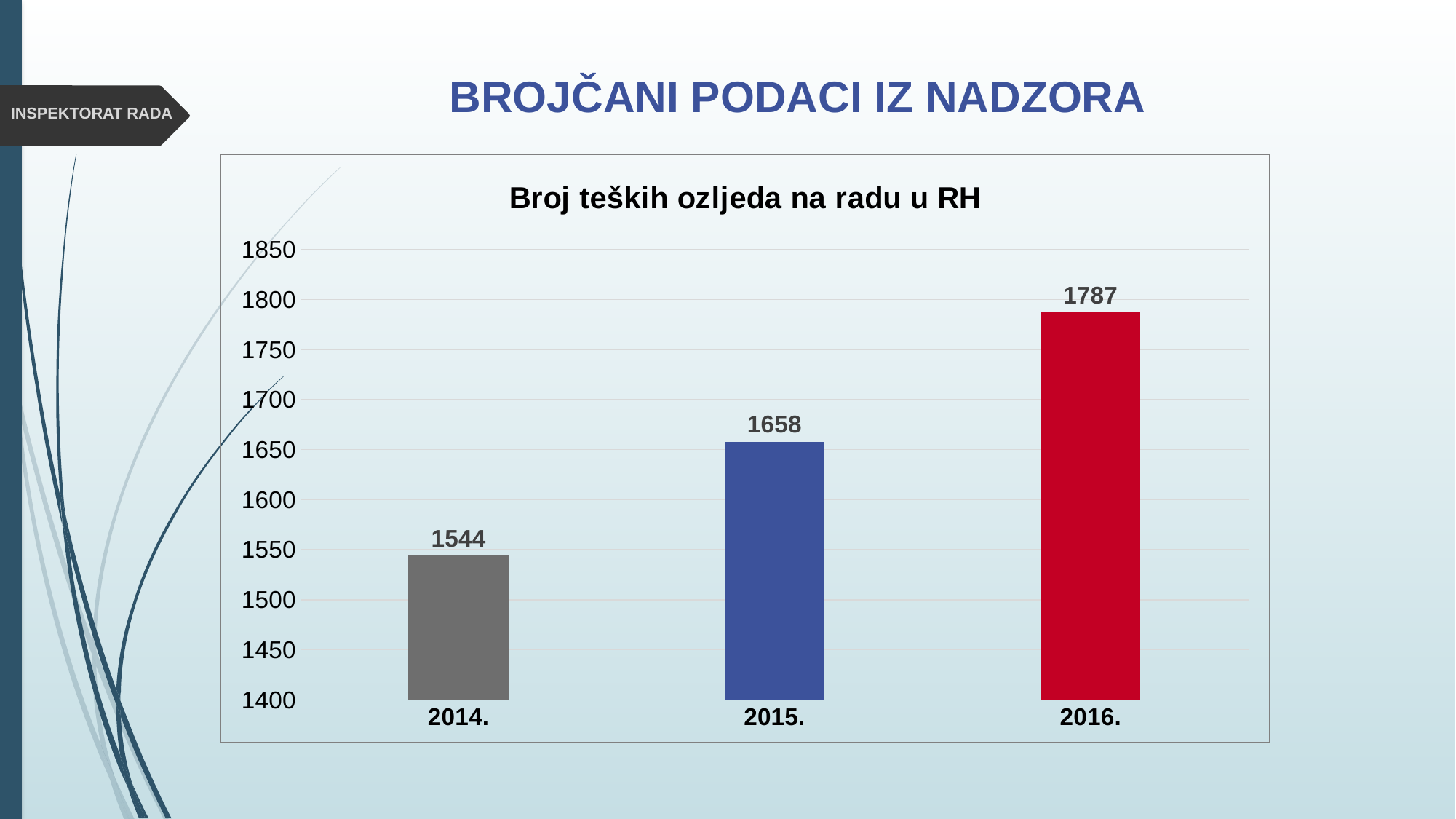
What is the value for 2015. in the chart? 1658 What is the value for 2014. in the chart? 1544 Which year has the highest number of serious injuries at work? 2016. What is the value for 2016. in the chart? 1787 Which is larger, the value for 2015. or the value for 2016.? 2016. Do the values rise or fall from 2014. to 2016.? rise What is the difference between the values for 2015. and 2014.? 114 Is the value for 2015. greater or less than 1700? less How many years are shown in the chart? 3 What is the difference between the values for 2016. and 2014.? 243 What kind of chart is shown on the slide? bar chart Which year has the lowest number of serious injuries at work? 2014.